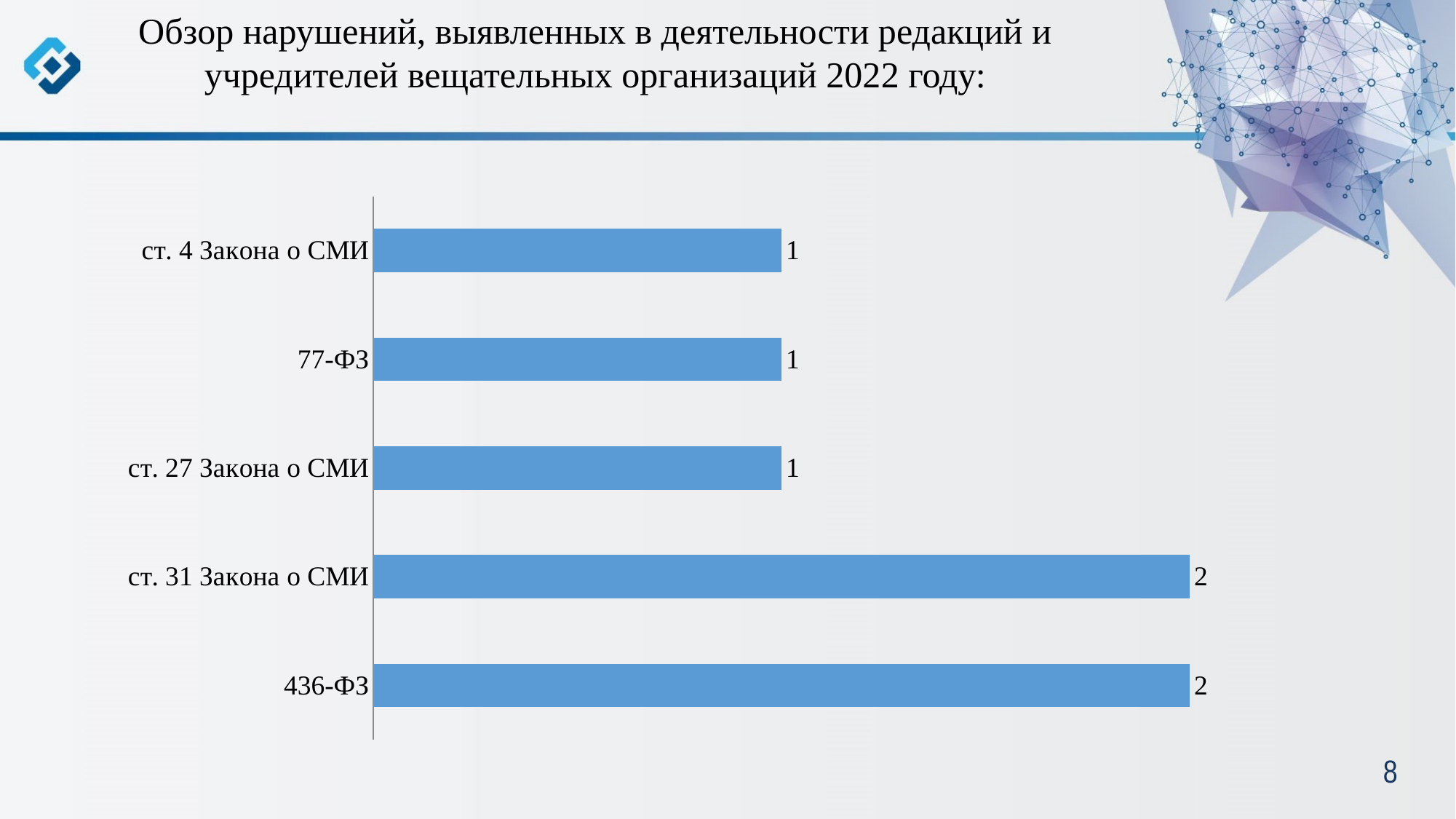
What kind of chart is shown on the slide? bar chart Which is larger, the value for 436-ФЗ or the value for ст. 27 Закона о СМИ? 436-ФЗ What colour are the bars in the chart? blue What value is shown for 77-ФЗ? 1 What value is shown for ст. 31 Закона о СМИ? 2 How many categories are shown in the chart? 5 What value is shown for ст. 4 Закона о СМИ? 1 Which is larger, the value for ст. 31 Закона о СМИ or the value for ст. 4 Закона о СМИ? ст. 31 Закона о СМИ What is the difference between the values for 436-ФЗ and 77-ФЗ? 1 What value is shown for ст. 27 Закона о СМИ? 1 What is the total of all the values shown in the chart? 7 What value is shown for 436-ФЗ? 2